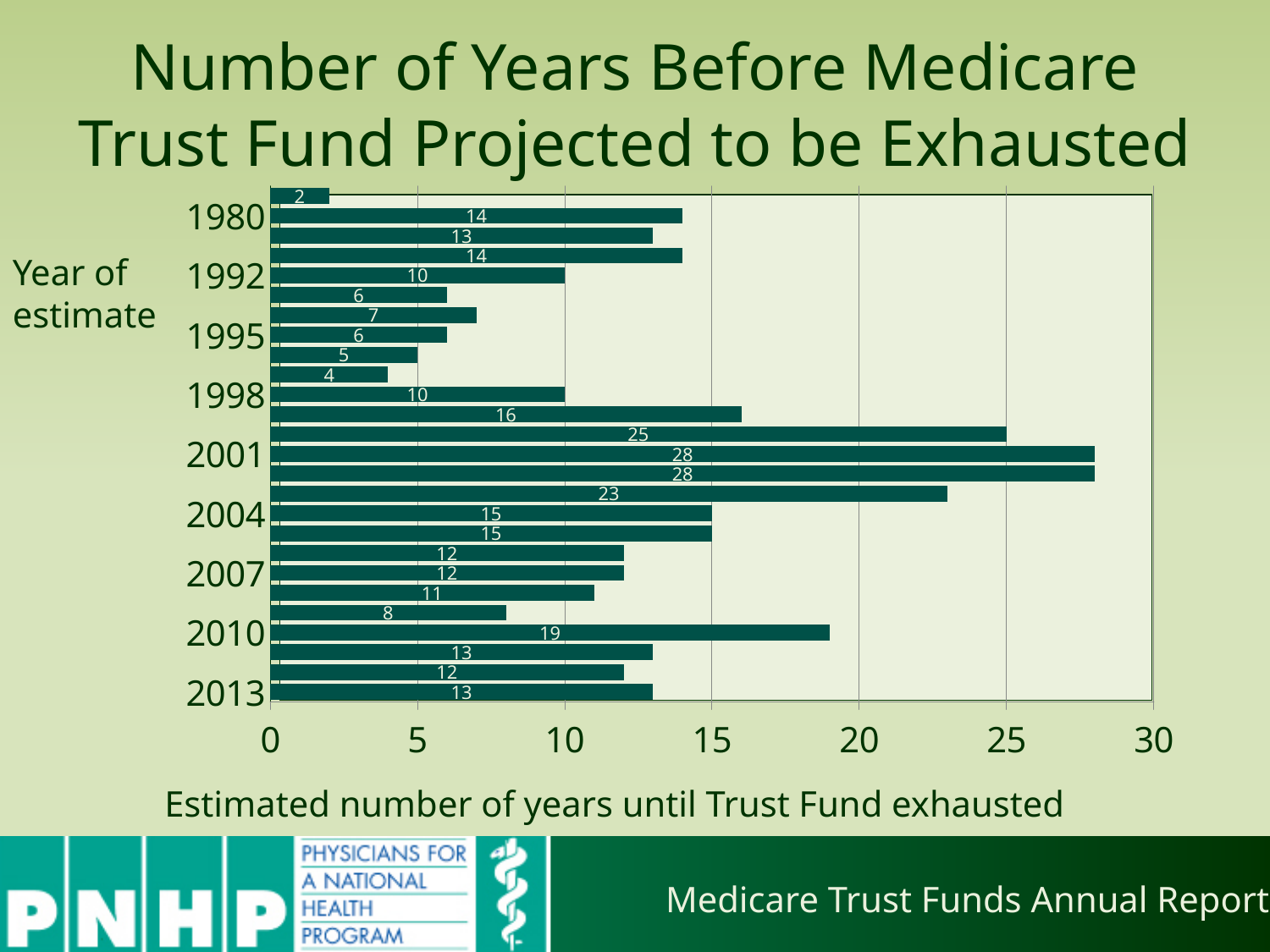
What is the lowest value shown by any bar in the chart? 2 What is the label on the horizontal axis of the chart? Estimated number of years until Trust Fund exhausted What kind of chart is shown on the slide? bar chart What is the estimated number of years until the Trust Fund is exhausted for the 2013 estimate? 13 Which estimate year shows a larger value, 2010 or 2007? 2010 Is the value for the 2001 estimate greater or less than 25? greater What is the estimated number of years until the Trust Fund is exhausted for the 1995 estimate? 6 How many years greater is the 2001 estimate than the 2013 estimate? 15 What is the estimated number of years until the Trust Fund is exhausted for the 2010 estimate? 19 What is the title of the chart? Number of Years Before Medicare Trust Fund Projected to be Exhausted What is the highest value shown by any bar in the chart? 28 What is the estimated number of years until the Trust Fund is exhausted for the 2001 estimate? 28